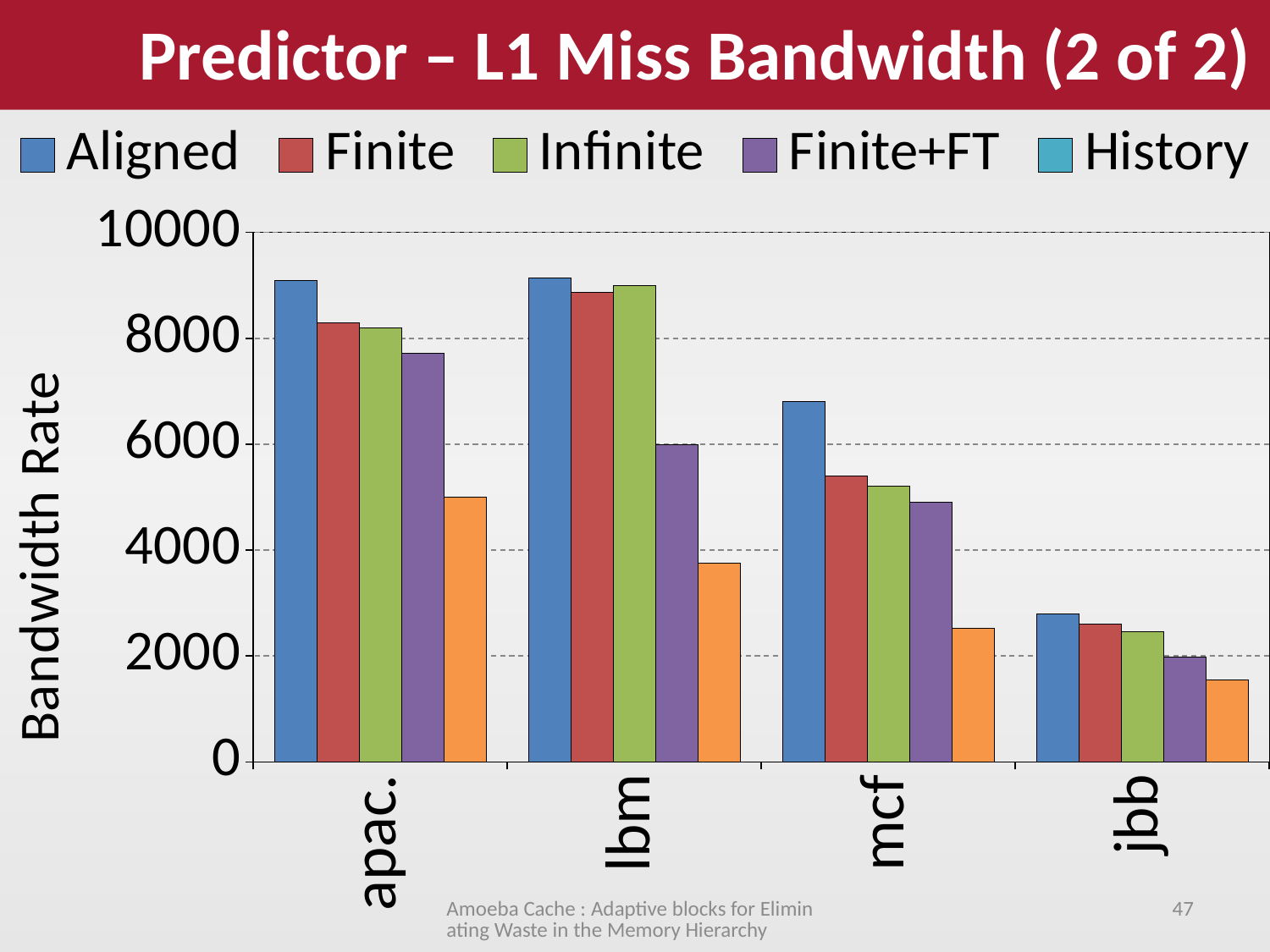
What is the title of the slide? Predictor – L1 Miss Bandwidth (2 of 2) Which category has the lowest Aligned value? jbb Is the Finite+FT value for apac. greater or less than 8000? less Do the History values rise or fall from apac. to jbb? fall Is the Aligned value for mcf greater or less than 6000? greater How many categories are shown on the x axis? 4 Which series has the highest value for mcf? Aligned How many series does the legend list? 5 Is the History value for lbm greater or less than 4000? less What kind of chart is shown on the slide? bar chart What is the title of the y axis? Bandwidth Rate